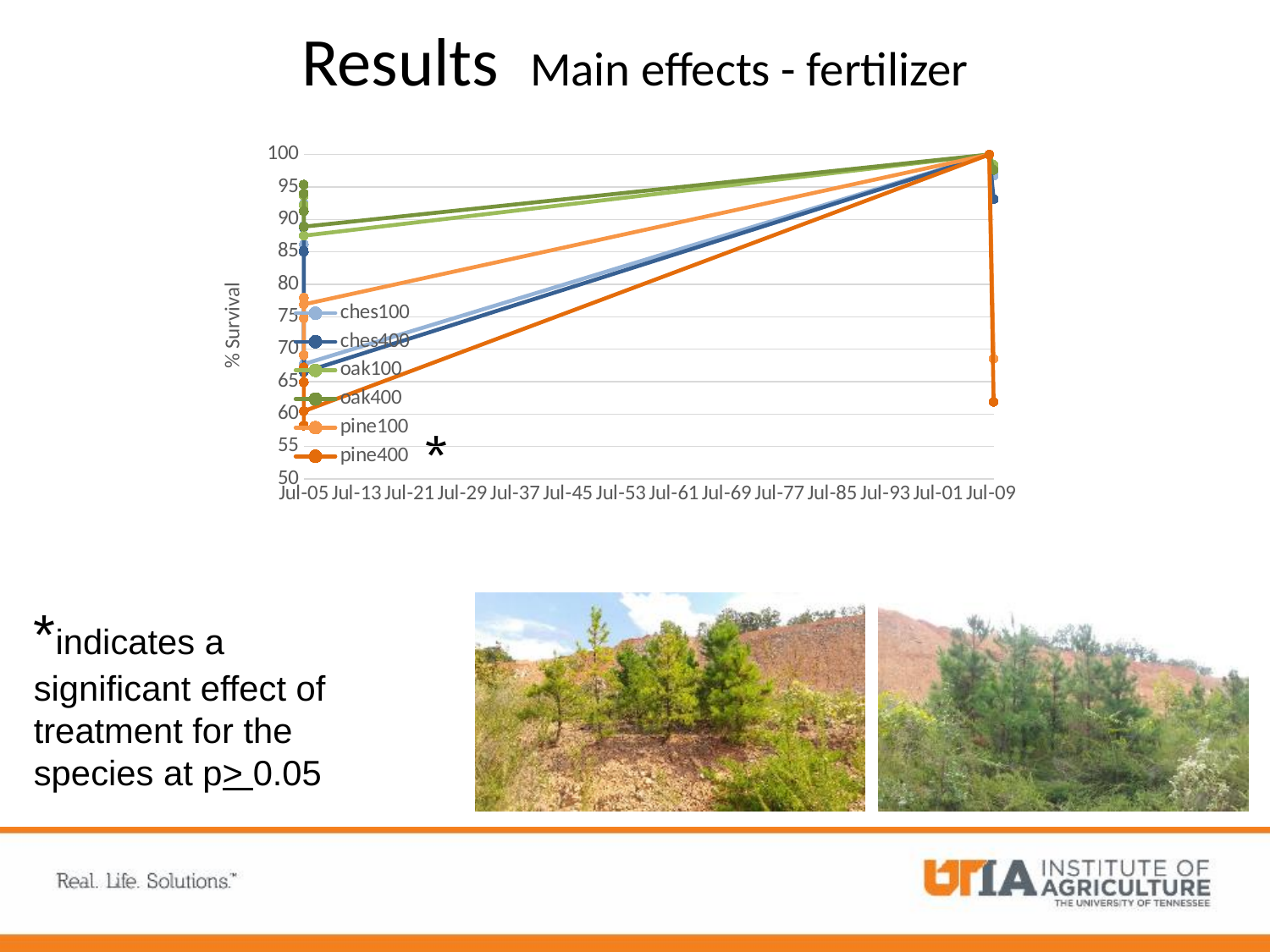
What kind of chart is shown on the slide? line chart Which series has the lowest value at the right-hand end of the chart? pine400 What is the label on the vertical axis of the chart? % Survival How many date labels are shown along the horizontal axis of the chart? 14 Is the final value for pine400 at the right-hand end of the chart greater or less than 70? less Is the final value for oak400 at the right-hand end of the chart greater or less than 95? greater At the right-hand end of the chart, which is larger: the value for ches400 or the value for pine400? ches400 What are the series names listed in the chart legend? ches100, ches400, oak100, oak400, pine100, pine400 What is the highest value shown on the vertical axis of the chart? 100 Is the final value for ches400 at the right-hand end of the chart greater or less than 90? greater What is the lowest value shown on the vertical axis of the chart? 50 How many series does the chart legend list? 6